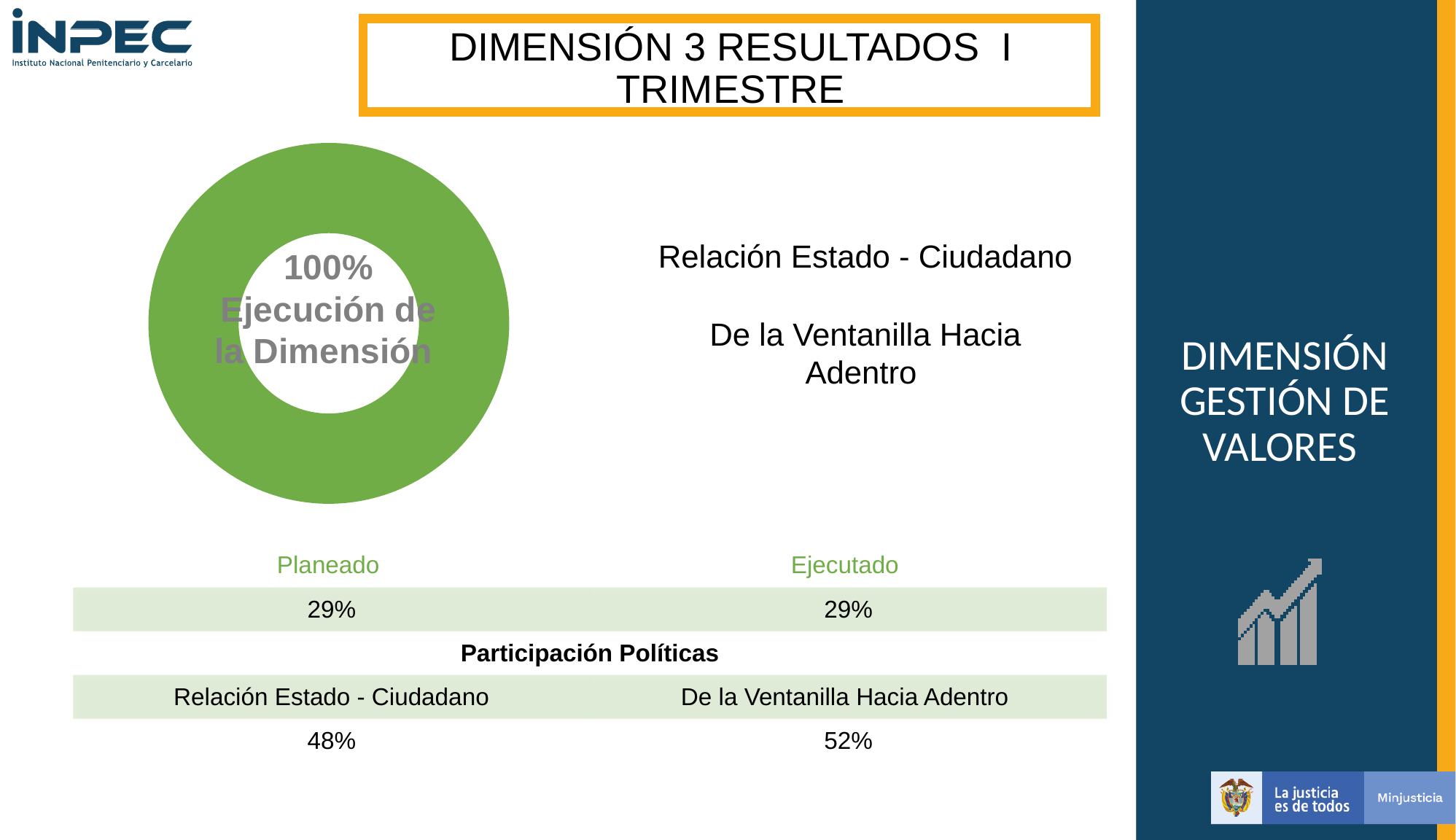
What colour is the ring of the doughnut chart? Green What does the label inside the doughnut chart say the 100% represents? Ejecución de la Dimensión How many distinct slices does the doughnut chart show? 1 What percentage is printed in the centre of the doughnut chart? 100% What kind of chart is shown on the left of the slide? Doughnut chart What share of the doughnut chart does the green slice occupy? 100%